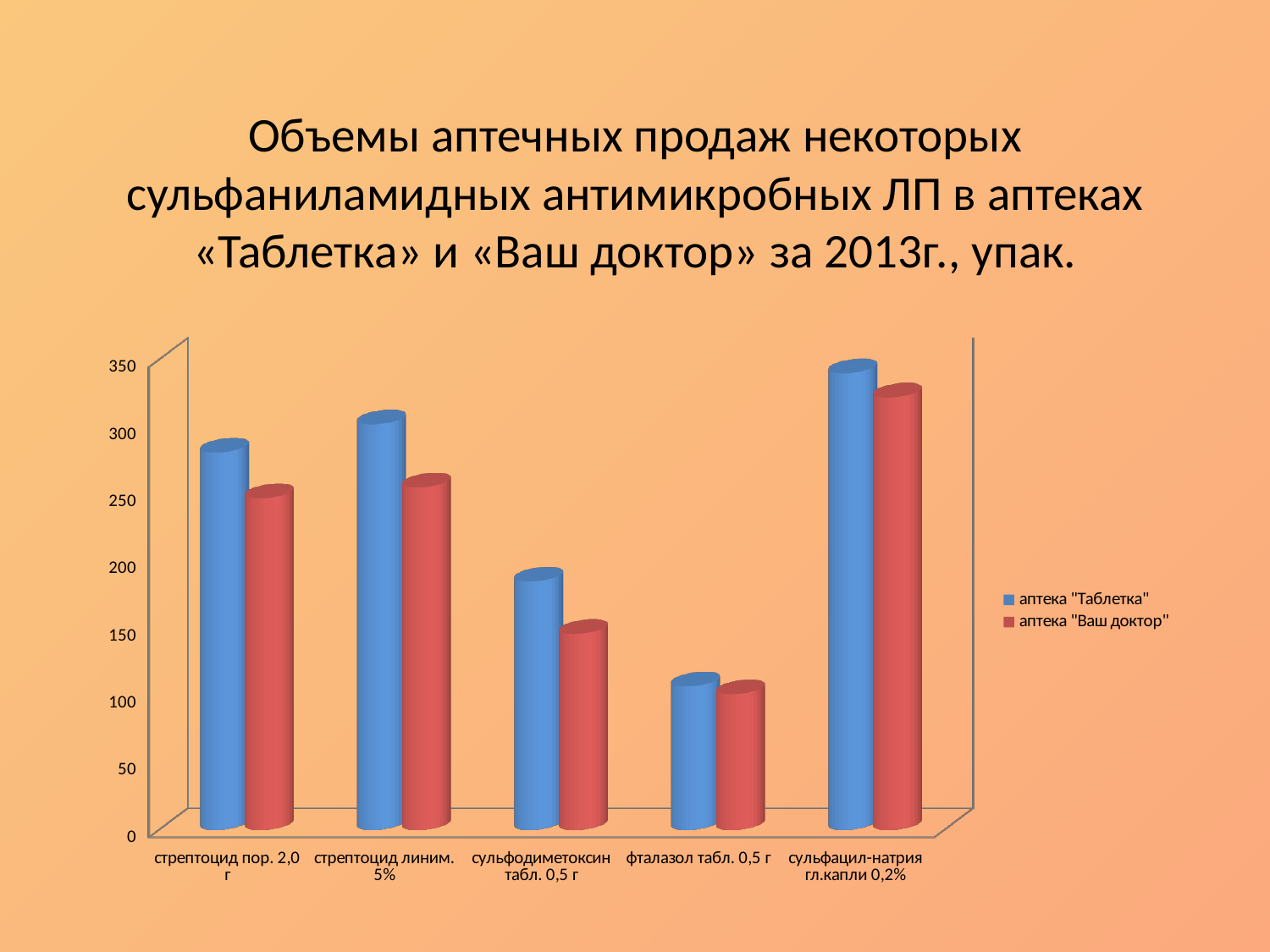
Is the value for аптека "Таблетка" for фталазол табл. 0,5 г greater or less than 150? less Which colour represents аптека "Ваш доктор" in the chart? red Is the value for аптека "Ваш доктор" for сульфацил-натрия гл.капли 0,2% greater or less than 300? greater How many series does the legend list? 2 What kind of chart is shown on the slide? bar chart Which category has the lowest value for аптека "Таблетка"? фталазол табл. 0,5 г For сульфодиметоксин табл. 0,5 г, which pharmacy has the larger value, аптека "Таблетка" or аптека "Ваш доктор"? аптека "Таблетка" Which category has the highest value for аптека "Таблетка"? сульфацил-натрия гл.капли 0,2% How many drug categories are shown on the x axis? 5 Which category has the lowest value for аптека "Ваш доктор"? фталазол табл. 0,5 г Is the value for аптека "Таблетка" for стрептоцид пор. 2,0 г greater or less than 250? greater For стрептоцид пор. 2,0 г, which pharmacy has the larger value, аптека "Таблетка" or аптека "Ваш доктор"? аптека "Таблетка"